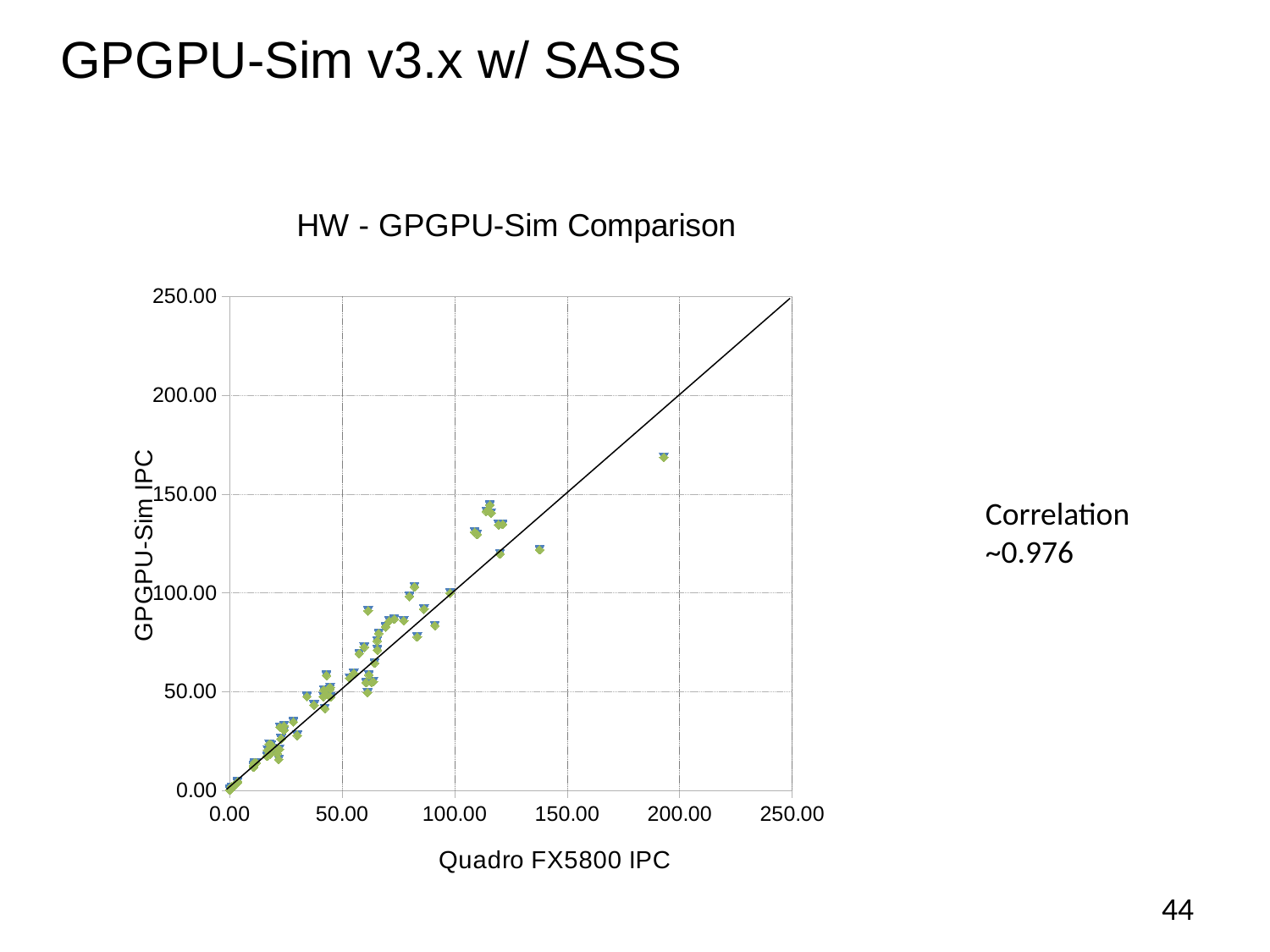
How many points have a GPGPU-Sim IPC value above 150? 1 What kind of chart is shown on the slide? scatter chart Is the GPGPU-Sim IPC value of the rightmost point greater or less than 200? less Is the GPGPU-Sim IPC value of the point at about 100 on the horizontal axis greater or less than 50? greater Is the GPGPU-Sim IPC value of the rightmost point greater or less than 150? greater What is the title of the chart? HW - GPGPU-Sim Comparison What is the label of the vertical axis of the chart? GPGPU-Sim IPC As Quadro FX5800 IPC increases along the horizontal axis, do the GPGPU-Sim IPC values generally rise or fall? rise What is the highest value shown on the horizontal axis of the chart? 250.00 How many points have a Quadro FX5800 IPC value above 150? 1 What is the highest value shown on the vertical axis of the chart? 250.00